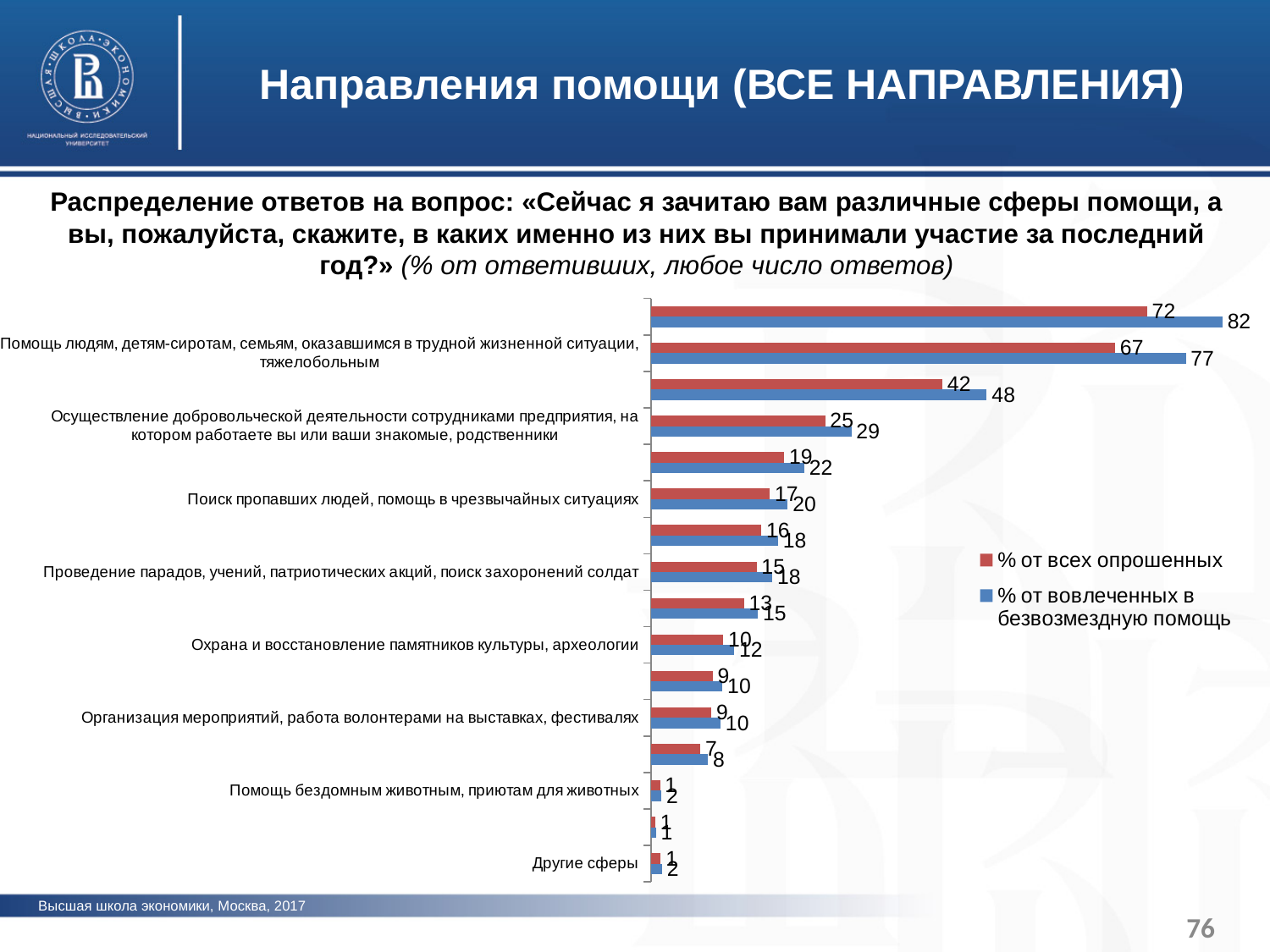
What is the highest value shown for the series '% от вовлеченных в безвозмездную помощь'? 82 What type of chart is shown on the slide? Bar chart What is the highest value shown for the series '% от всех опрошенных'? 72 Which series is shown in red in the chart? % от всех опрошенных For 'Помощь людям, детям-сиротам, семьям, оказавшимся в трудной жизненной ситуации, тяжелобольным', what is the difference between '% от вовлеченных в безвозмездную помощь' and '% от всех опрошенных'? 10 What is the value of '% от вовлеченных в безвозмездную помощь' for 'Осуществление добровольческой деятельности сотрудниками предприятия, на котором работаете вы или ваши знакомые, родственники'? 29 What is the value of '% от вовлеченных в безвозмездную помощь' for 'Охрана и восстановление памятников культуры, археологии'? 12 How many series does the legend list? 2 For 'Проведение парадов, учений, патриотических акций, поиск захоронений солдат', which series has the larger value? % от вовлеченных в безвозмездную помощь What is the value of '% от всех опрошенных' for 'Помощь людям, детям-сиротам, семьям, оказавшимся в трудной жизненной ситуации, тяжелобольным'? 67 How many category groups (pairs of bars) are plotted in the chart? 16 What is the value of '% от всех опрошенных' for 'Поиск пропавших людей, помощь в чрезвычайных ситуациях'? 17